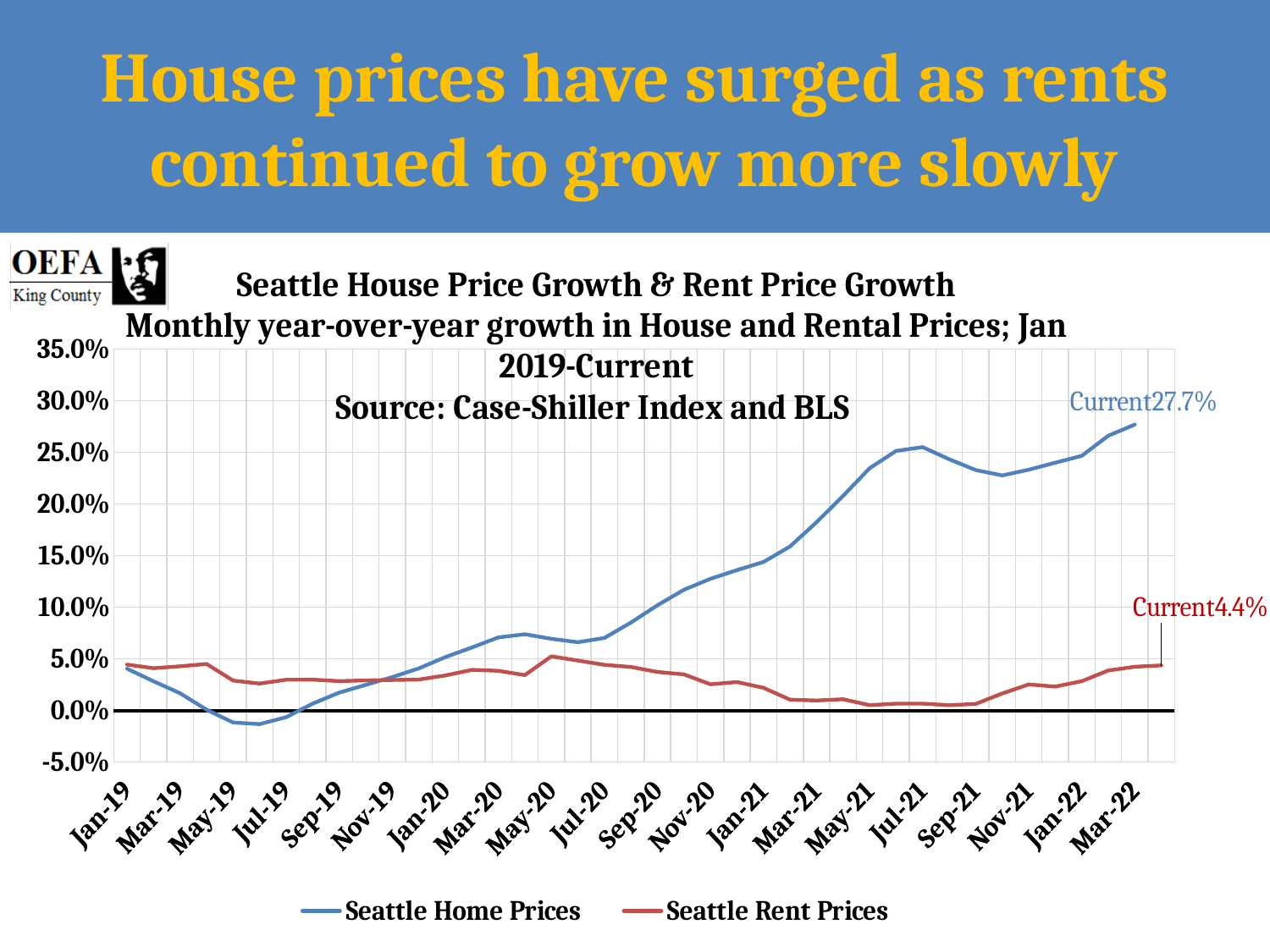
What is the current value labelled for Seattle Home Prices? 27.7% What colour is the Seattle Rent Prices line? Red What is the current value labelled for Seattle Rent Prices? 4.4% Which series reaches the highest value on the chart? Seattle Home Prices What is the difference between the current Seattle Home Prices value and the current Seattle Rent Prices value? 23.3% Is the value for Seattle Home Prices in May-19 greater or less than 0.0%? less What kind of chart is shown on the slide? Line chart Does the Seattle Home Prices line rise or fall between Jan-21 and Jul-21? Rise Is the value for Seattle Rent Prices in May-21 greater or less than 5.0%? less At the current point, which series is higher: Seattle Home Prices or Seattle Rent Prices? Seattle Home Prices How many series does the legend list? 2 Is the value for Seattle Home Prices in Jul-21 greater or less than 20.0%? greater